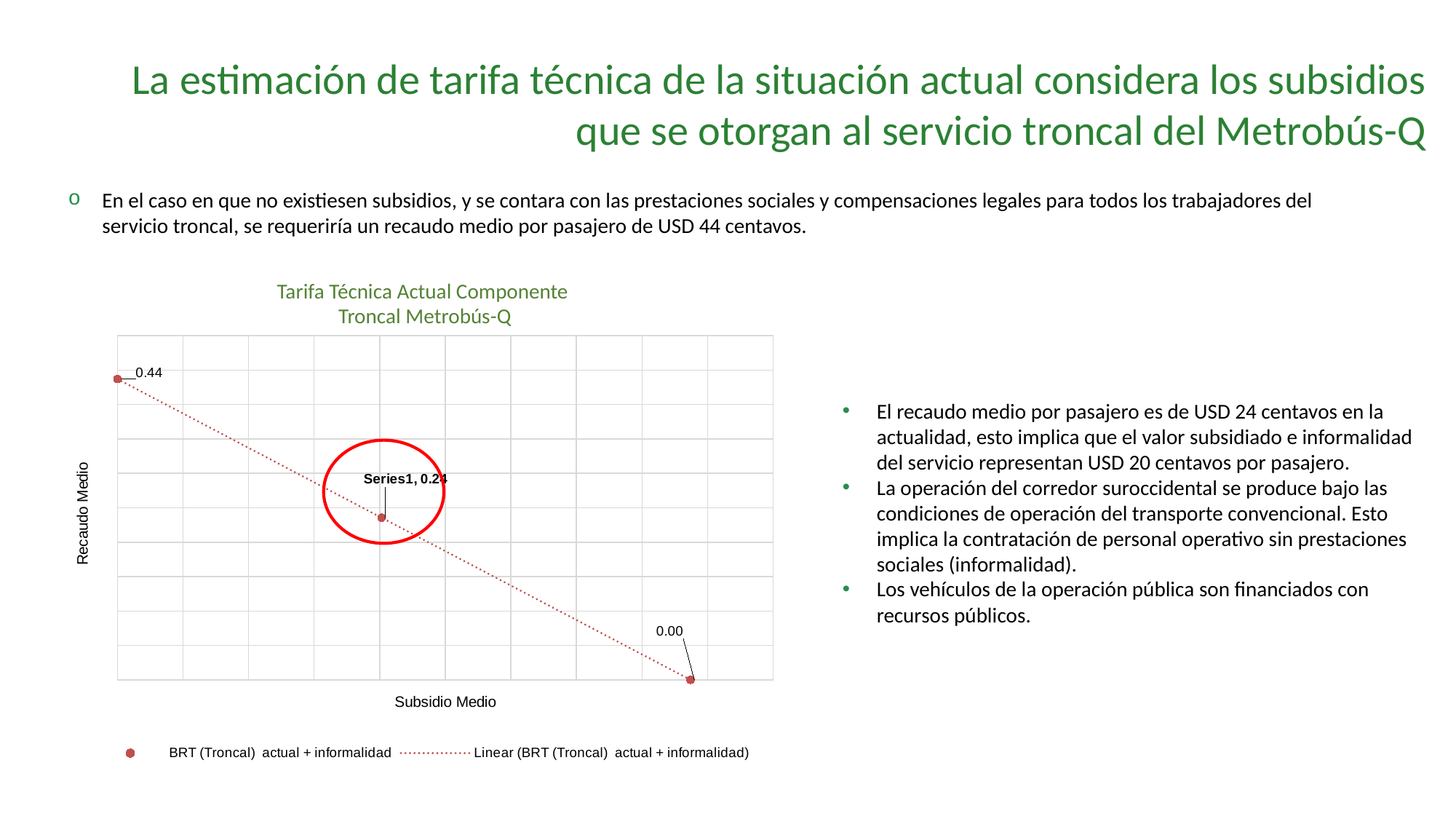
What kind of chart is shown on the slide? Scatter chart What is the highest Recaudo Medio value labelled on the chart? 0.44 What is the lowest Recaudo Medio value labelled on the chart? 0.00 What is the label of the x axis? Subsidio Medio Which is larger, the point labelled 0.44 or the point labelled Series1, 0.24? 0.44 What is the difference between the highest labelled point (0.44) and the circled point (0.24)? 0.20 What is the Recaudo Medio value of the circled point labelled Series1? 0.24 What is the title of the chart? Tarifa Técnica Actual Componente Troncal Metrobús-Q How many entries does the chart legend list? 2 How many data points are plotted in the chart? 3 Does Recaudo Medio rise or fall as Subsidio Medio increases along the x axis? Fall